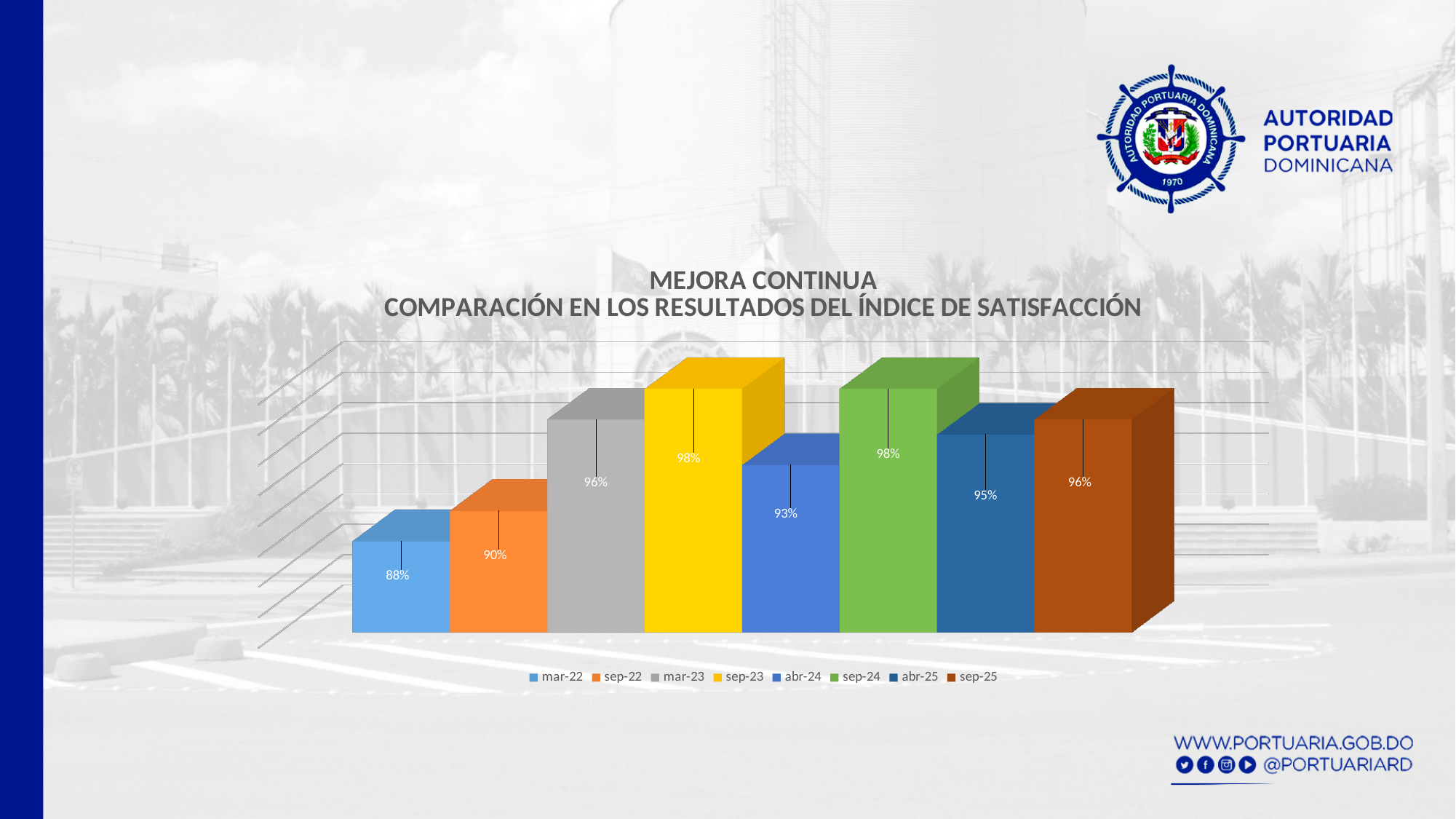
Which is larger, the value for abr-24 or the value for abr-25? abr-25 Which period has the lowest value? mar-22 What kind of chart is shown on the slide? Bar chart What is the value for sep-22? 90% What is the value for abr-24? 93% What is the value for sep-25? 96% How many bars are plotted in the chart? 8 Which periods share the highest value? sep-23 and sep-24 What is the value for mar-22? 88% What is the value for abr-25? 95% What is the difference between the values for sep-23 and mar-22? 10% How many entries does the legend list? 8